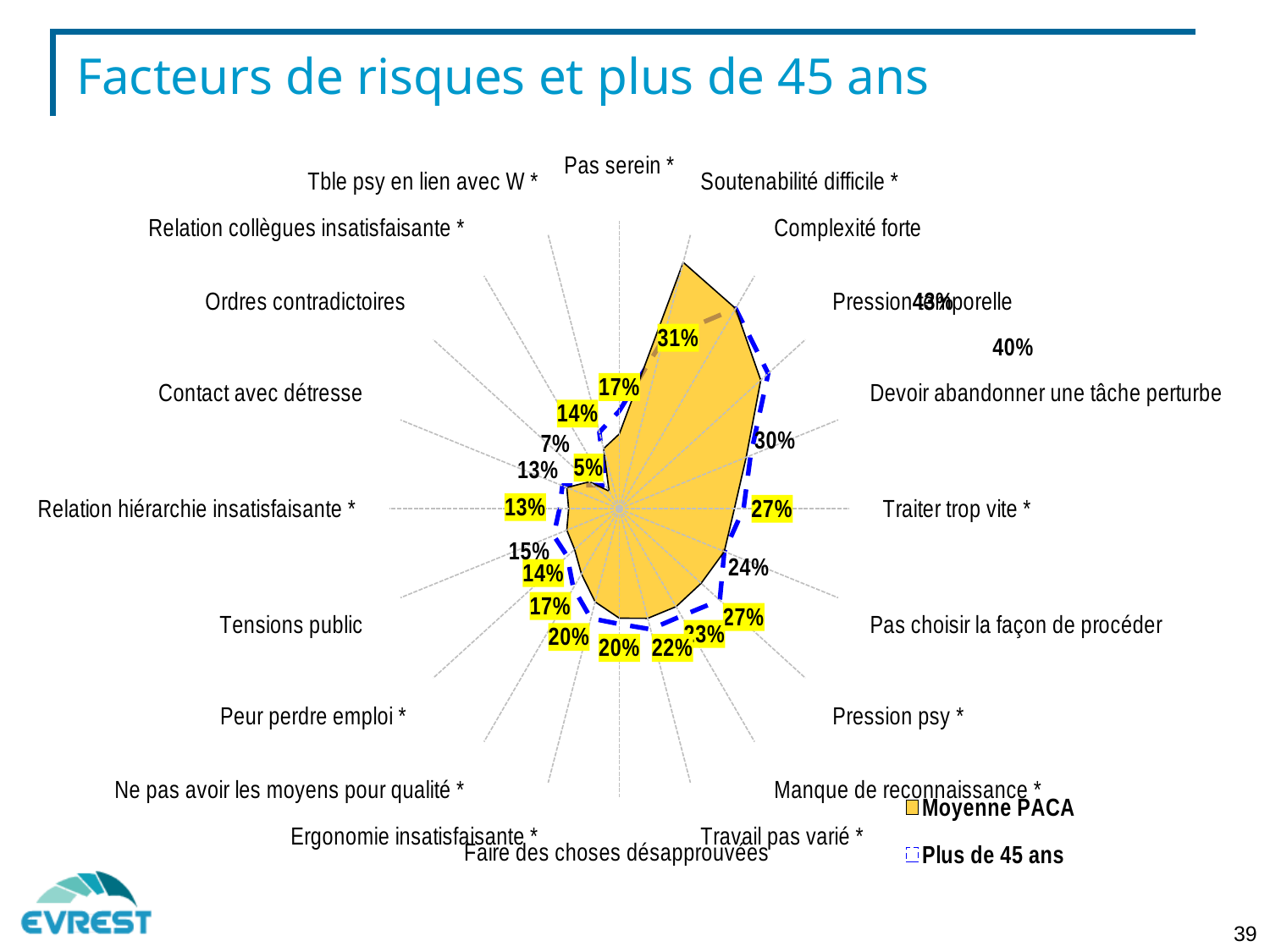
Which is larger, the labelled value for 'Traiter trop vite *' or for 'Relation hiérarchie insatisfaisante *'? Traiter trop vite * What are the two series named in the legend? Moyenne PACA and Plus de 45 ans What value is labelled on the 'Traiter trop vite *' axis? 27% What kind of chart is shown on the slide? Radar chart What is the title of the slide containing the chart? Facteurs de risques et plus de 45 ans What value is labelled on the 'Relation hiérarchie insatisfaisante *' axis? 13% Which series is drawn as a dashed blue line? Plus de 45 ans How many categories (axes) does the radar chart have? 20 What is the difference between the labelled values for 'Traiter trop vite *' (27%) and 'Relation hiérarchie insatisfaisante *' (13%)? 14% How many series does the legend list? 2